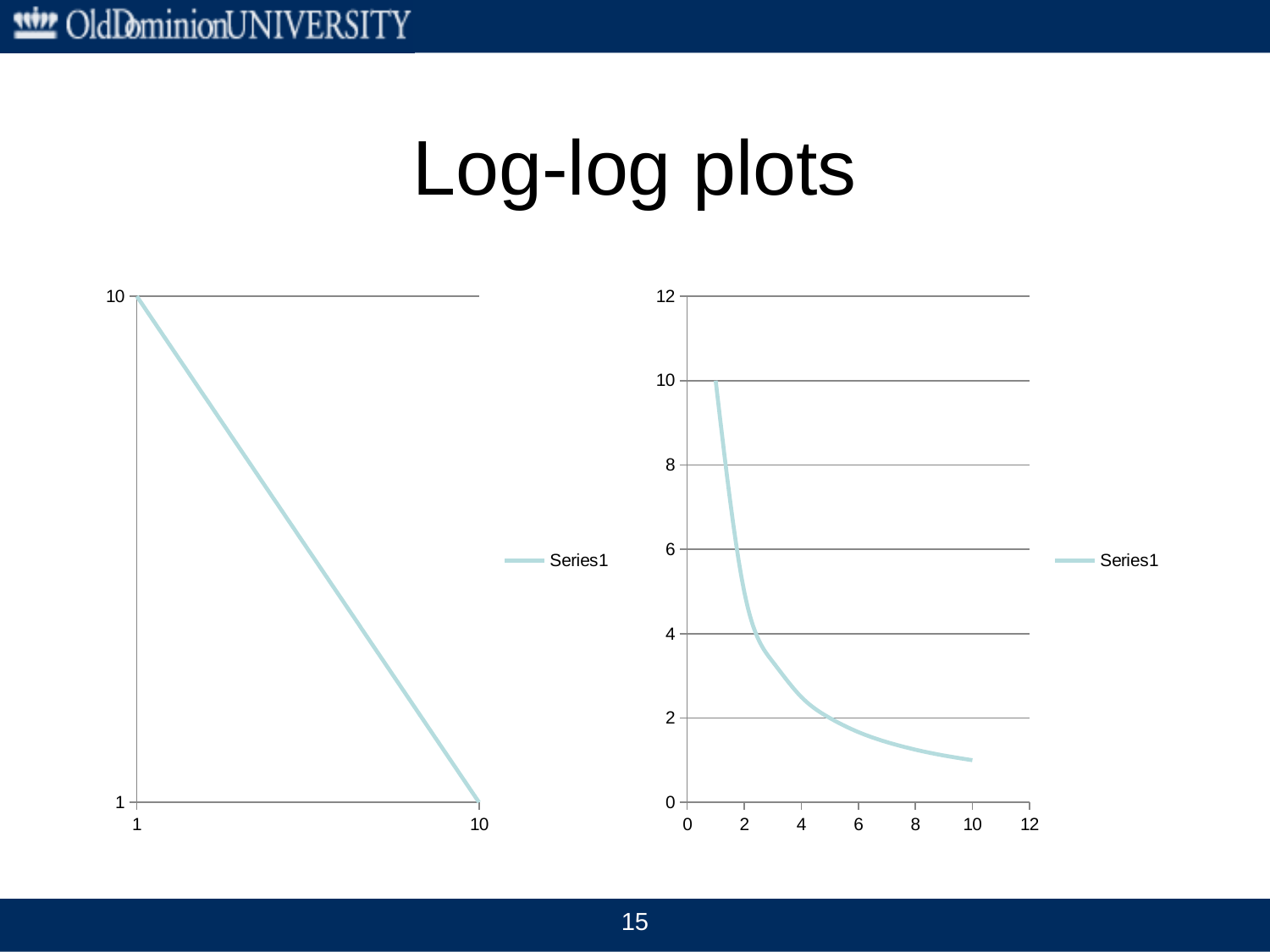
What kind of chart is the left chart on the slide? line chart How many series does the legend of the left chart list? 1 In the left chart, what is the value of Series1 at x = 10? 1 In the left chart, do the values rise or fall as x increases from 1 to 10? fall In the right chart, is the value of Series1 at x = 2 greater or less than 4? greater In the right chart, is the value of Series1 at x = 8 greater or less than 2? less What is the name of the series shown in the legend of the right chart? Series1 In the right chart, do the values rise or fall as x increases? fall In the left chart, what is the value of Series1 at x = 1? 10 How many series does the legend of the right chart list? 1 What kind of chart is the right chart on the slide? line chart In the right chart, is the value of Series1 at x = 10 greater or less than 2? less